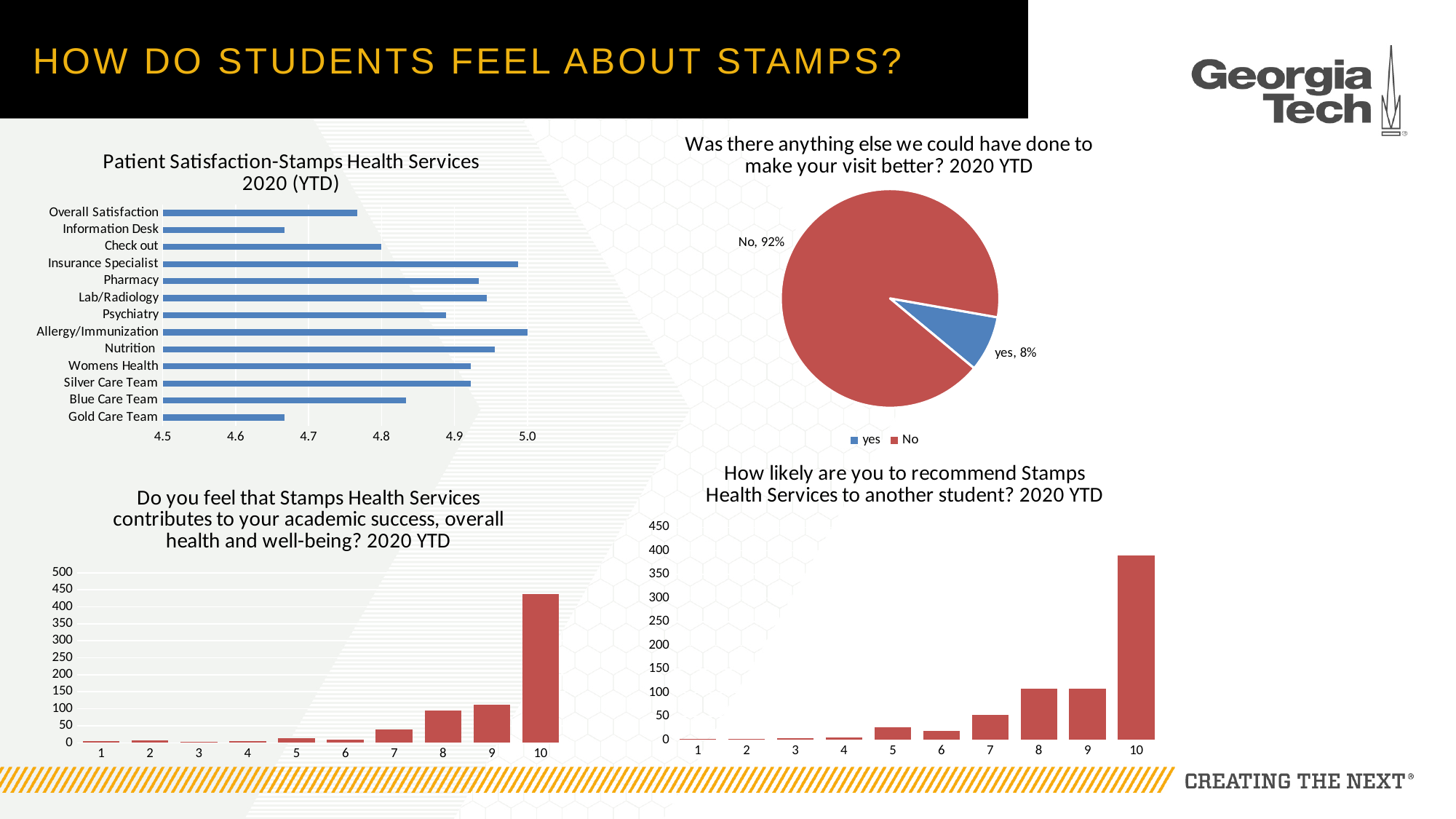
In the 'Patient Satisfaction-Stamps Health Services 2020 (YTD)' chart, is the value for Information Desk greater or less than 4.7? less In the pie chart 'Was there anything else we could have done to make your visit better? 2020 YTD', what share of responses is yes? 8% In the chart 'Do you feel that Stamps Health Services contributes to your academic success, overall health and well-being? 2020 YTD', which category has the highest value? 10 In the 'Patient Satisfaction-Stamps Health Services 2020 (YTD)' chart, which category has the highest value? Allergy/Immunization In the chart 'Do you feel that Stamps Health Services contributes to your academic success, overall health and well-being? 2020 YTD', is the value for 10 greater or less than 400? greater In the chart 'How likely are you to recommend Stamps Health Services to another student? 2020 YTD', is the value for 7 greater or less than 100? less In the chart 'How likely are you to recommend Stamps Health Services to another student? 2020 YTD', which category has the highest value? 10 How many categories are shown in the 'Patient Satisfaction-Stamps Health Services 2020 (YTD)' chart? 13 What type of chart is 'Was there anything else we could have done to make your visit better? 2020 YTD'? pie chart In the pie chart 'Was there anything else we could have done to make your visit better? 2020 YTD', what share of responses is No? 92% In the 'Patient Satisfaction-Stamps Health Services 2020 (YTD)' chart, which is larger, Check out or Blue Care Team? Blue Care Team